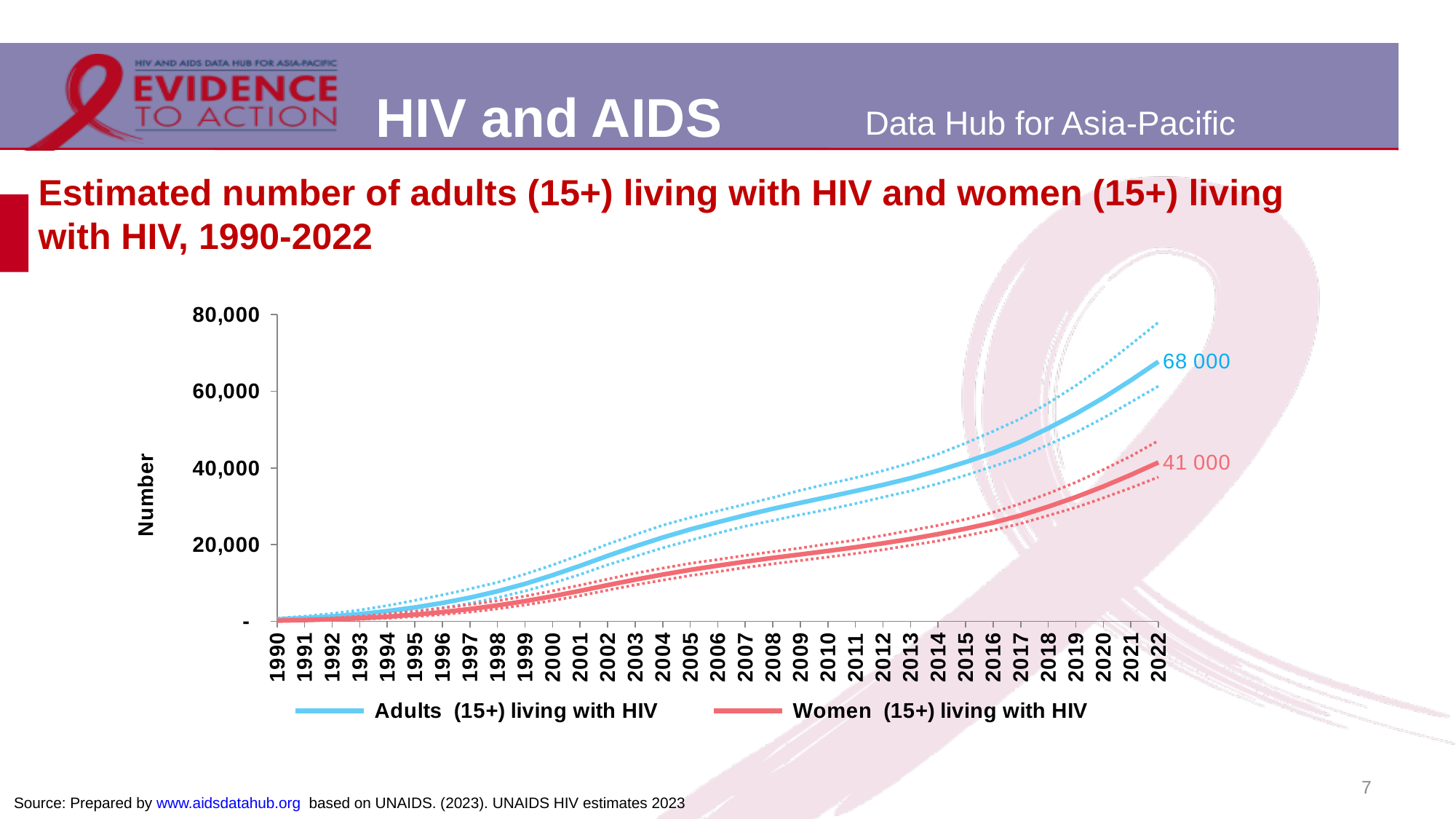
Is the value for Adults (15+) living with HIV in 2010 greater or less than 20,000? greater What kind of chart is shown on the slide? line chart Do the values for Adults (15+) living with HIV rise or fall from 1990 to 2022? rise Is the value for Adults (15+) living with HIV in 2000 greater or less than 20,000? less What is the difference between the number of adults (15+) living with HIV and women (15+) living with HIV in 2022? 27 000 What is the title of the vertical axis? Number What is the estimated number of adults (15+) living with HIV in 2022? 68 000 How many years are shown on the x axis of the chart? 33 In 2022, which series has the larger value: Adults (15+) living with HIV or Women (15+) living with HIV? Adults (15+) living with HIV Is the value for Women (15+) living with HIV in 2000 greater or less than 20,000? less What is the estimated number of women (15+) living with HIV in 2022? 41 000 How many series does the legend list? 2